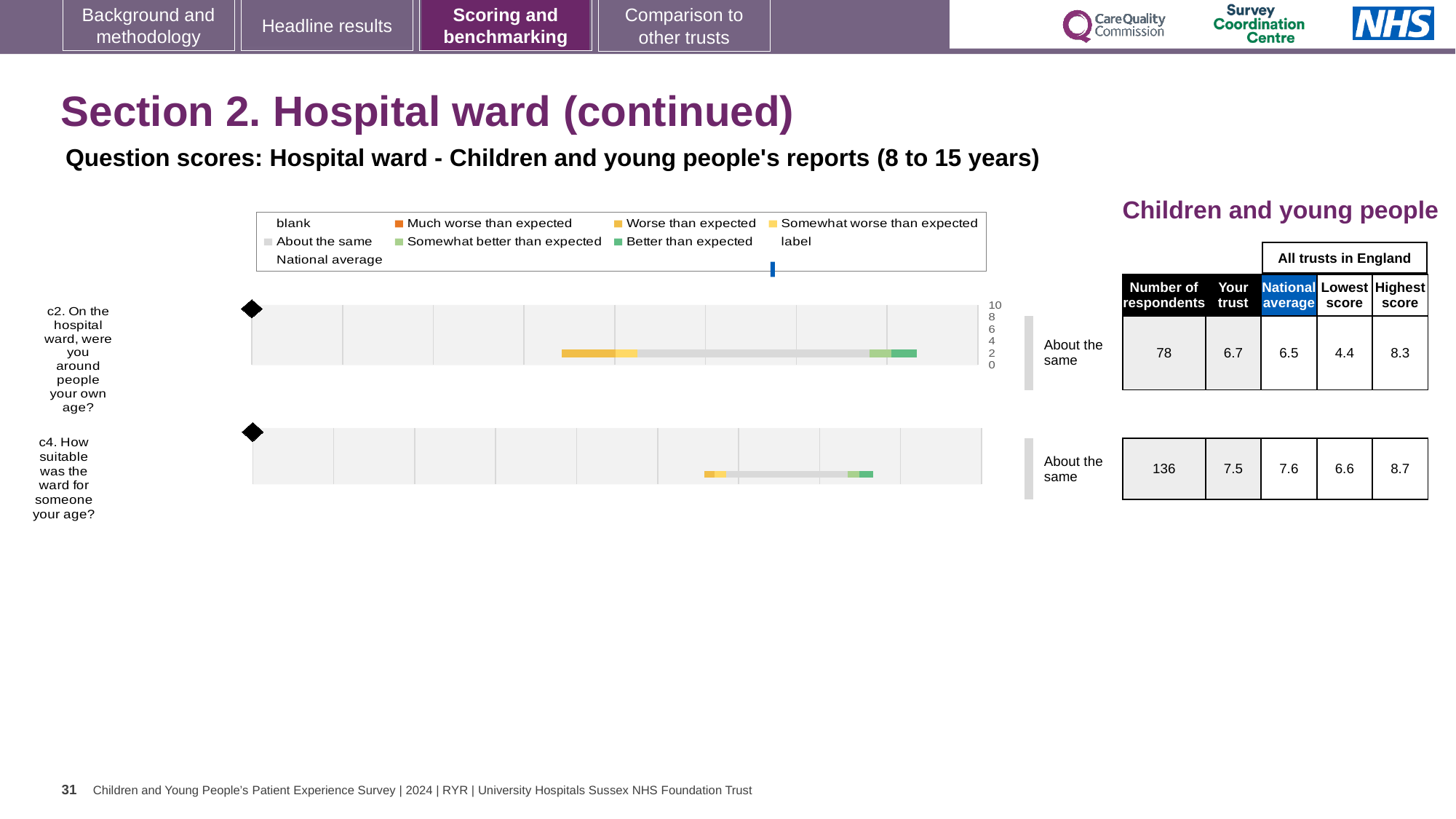
What benchmark rating is shown for question c2? About the same Which question has more respondents, c2 or c4? c4 What is the lowest score among all trusts in England for question c2? 4.4 What is the national average score for question c4 (How suitable was the ward for someone your age?)? 7.6 How many questions are plotted in the chart on this slide? 2 What type of chart is used to show the question scores on this slide? bar chart What is the difference between the highest and lowest scores for question c4? 2.1 What is the difference between the 'Your trust' score and the national average for question c2? 0.2 What is the 'Your trust' score for question c2? 6.7 Which question has the higher 'Your trust' score, c2 or c4? c4 What is the number of respondents for question c2 (On the hospital ward, were you around people your own age?)? 78 What is the highest score among all trusts in England for question c4? 8.7